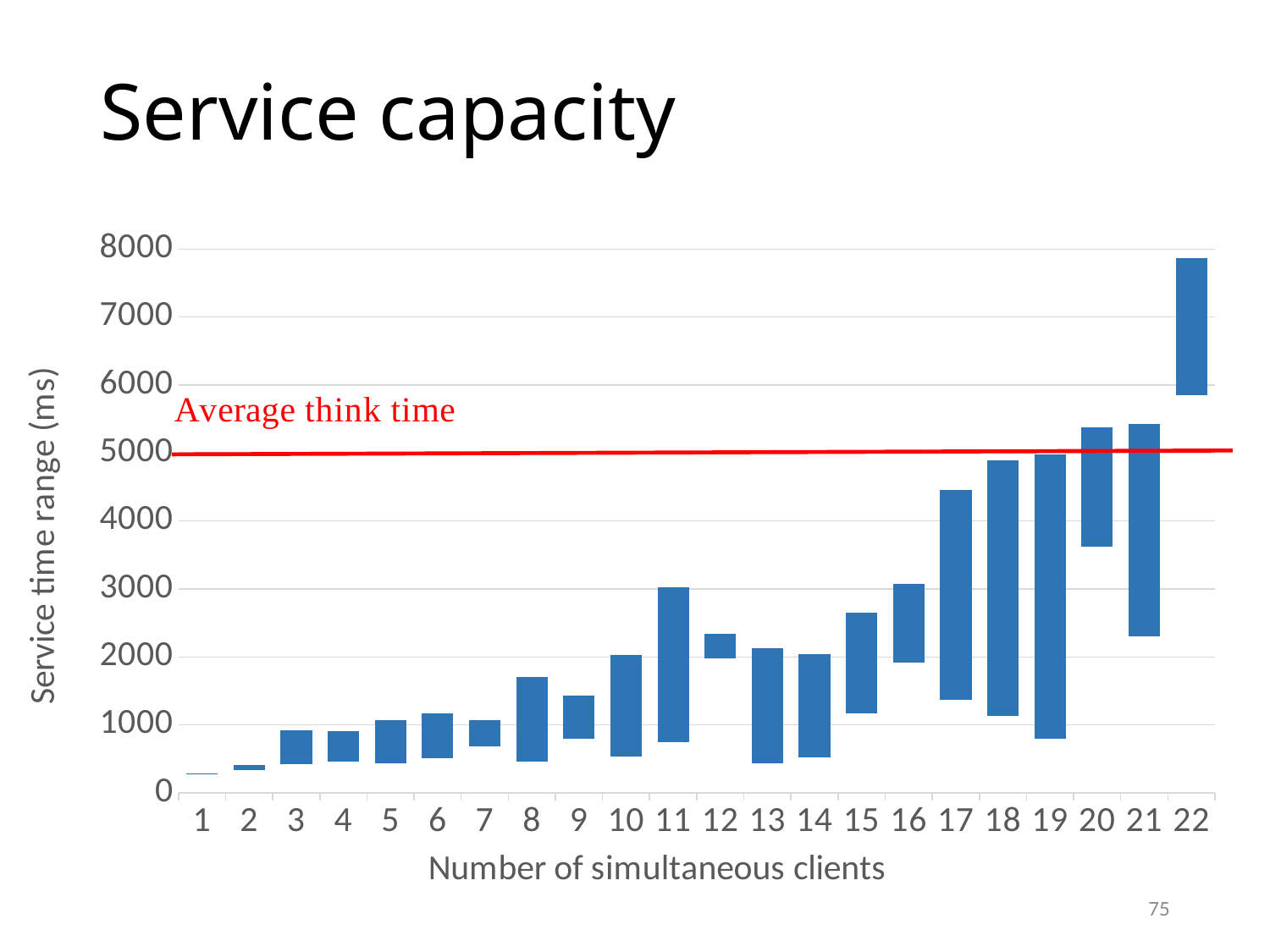
Is the top of the service time range for 22 clients greater or less than 7000? greater Which number of simultaneous clients has the highest top of its service time range? 22 What kind of chart is shown on the slide? Bar chart Is the top of the service time range for 15 clients greater or less than 3000? less Is the bottom of the service time range for 22 clients greater or less than 5000? greater Do the service time ranges generally rise or fall as the number of simultaneous clients increases? Rise How many client-count categories are plotted along the x axis? 22 Which reaches a higher top of service time range: 11 clients or 12 clients? 11 clients What does the red horizontal line on the chart represent? Average think time Which number of simultaneous clients has the lowest service time range? 1